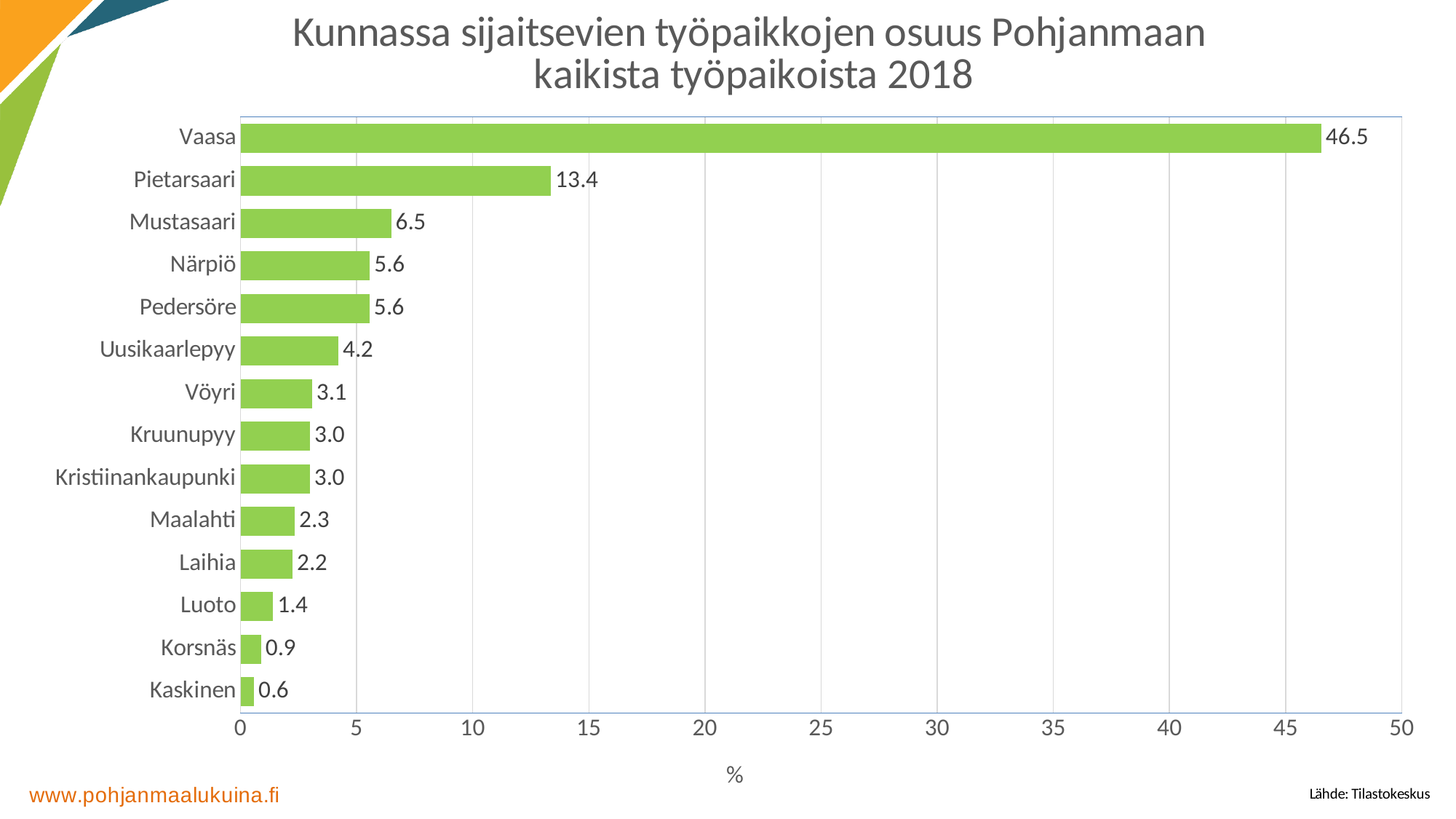
What is the value for Pietarsaari? 13.4 Which municipality has the lowest value? Kaskinen What is the difference between the values for Vaasa and Pietarsaari? 33.1 How many municipalities are shown in the chart? 14 Which is larger, the value for Maalahti or the value for Luoto? Maalahti Which municipality has the highest value? Vaasa What kind of chart is shown on the slide? bar chart What is the value for Uusikaarlepyy? 4.2 What is the difference between the values for Mustasaari and Närpiö? 0.9 What is the value for Vaasa? 46.5 Is the value for Pietarsaari greater or less than 10? greater What is the value for Korsnäs? 0.9